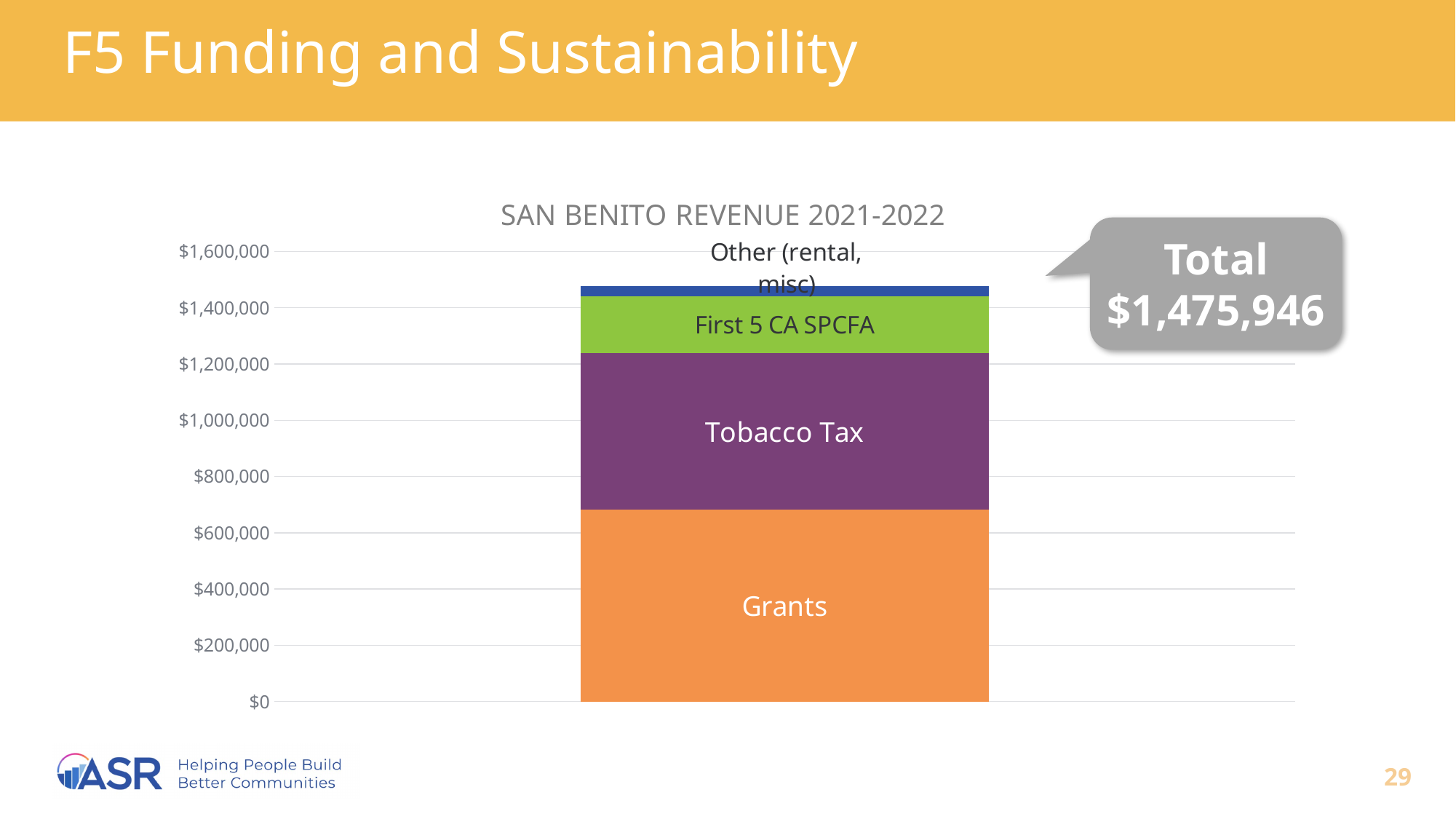
What kind of chart is shown on the slide? Stacked bar chart How many revenue segments make up the stacked bar? 4 What is the title of the chart? SAN BENITO REVENUE 2021-2022 What is the total revenue shown for San Benito in 2021-2022? $1,475,946 Which is larger, the Grants segment or the First 5 CA SPCFA segment? Grants Which revenue source is the largest segment of the bar? Grants Is the value for Grants greater or less than $800,000? less Is the value for Tobacco Tax greater or less than $400,000? greater Is the value for Grants greater or less than $600,000? greater Which revenue source is the smallest segment of the bar? Other (rental, misc) Which revenue source is shown at the bottom of the stacked bar? Grants